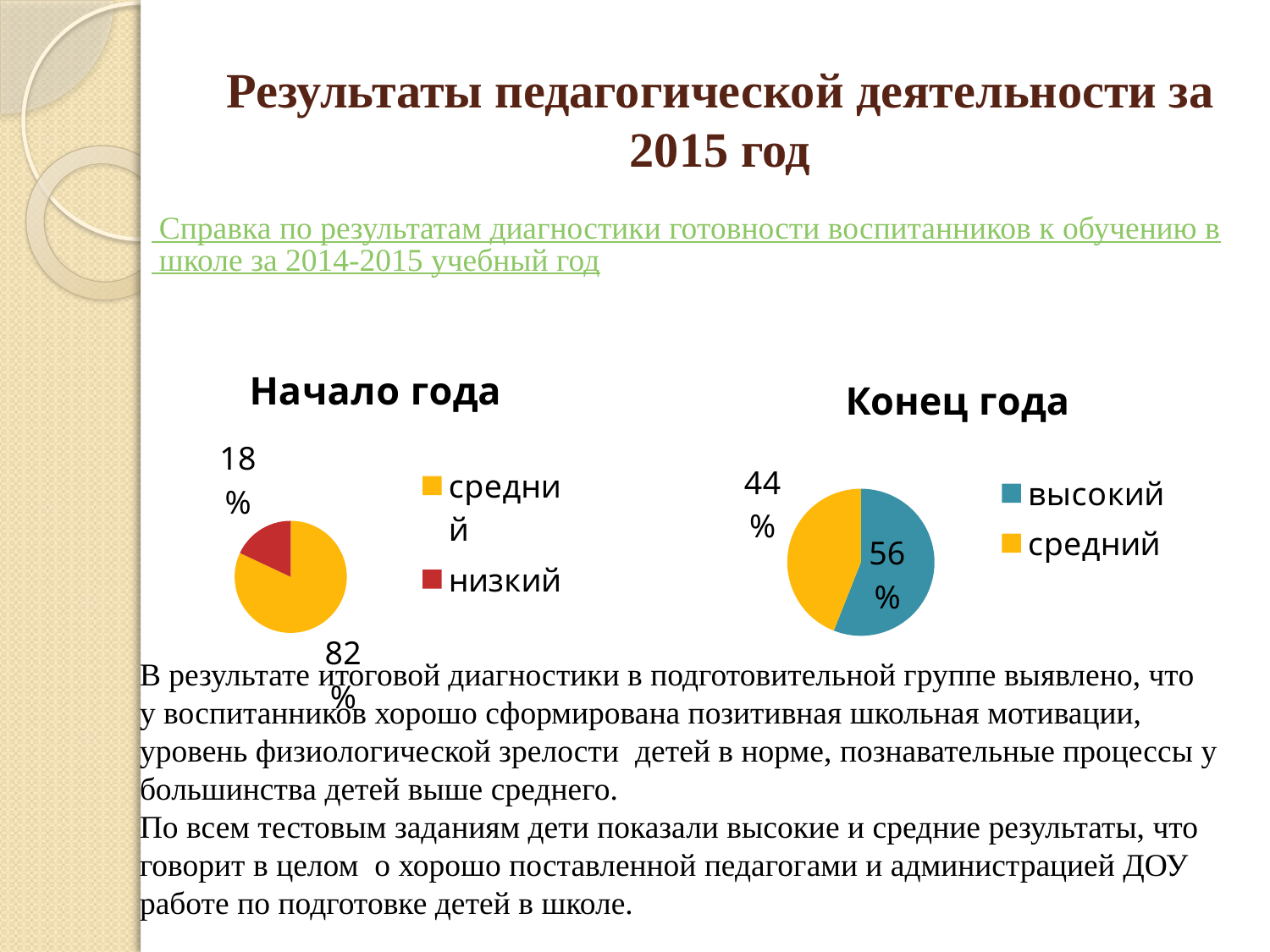
In the "Конец года" chart, what colour is the "высокий" slice? teal (blue-green) How many categories does the legend of the "Конец года" chart list? 2 What type of chart is the "Начало года" chart? pie chart In the "Конец года" chart, what is the difference in percentage points between the "высокий" and "средний" slices? 12 In the "Конец года" chart, what share is labelled for the "средний" slice? 44% In the "Начало года" chart, which category has the largest slice? средний In the "Конец года" chart, what share is labelled for the "высокий" slice? 56% In the "Конец года" chart, which category has the smallest slice? средний In the "Начало года" chart, what is the difference in percentage points between the "средний" and "низкий" slices? 64 In the "Конец года" chart, which slice is larger, "высокий" or "средний"? высокий In the "Начало года" chart, what share is labelled for the "средний" slice? 82% In the "Начало года" chart, what share is labelled for the "низкий" slice? 18%